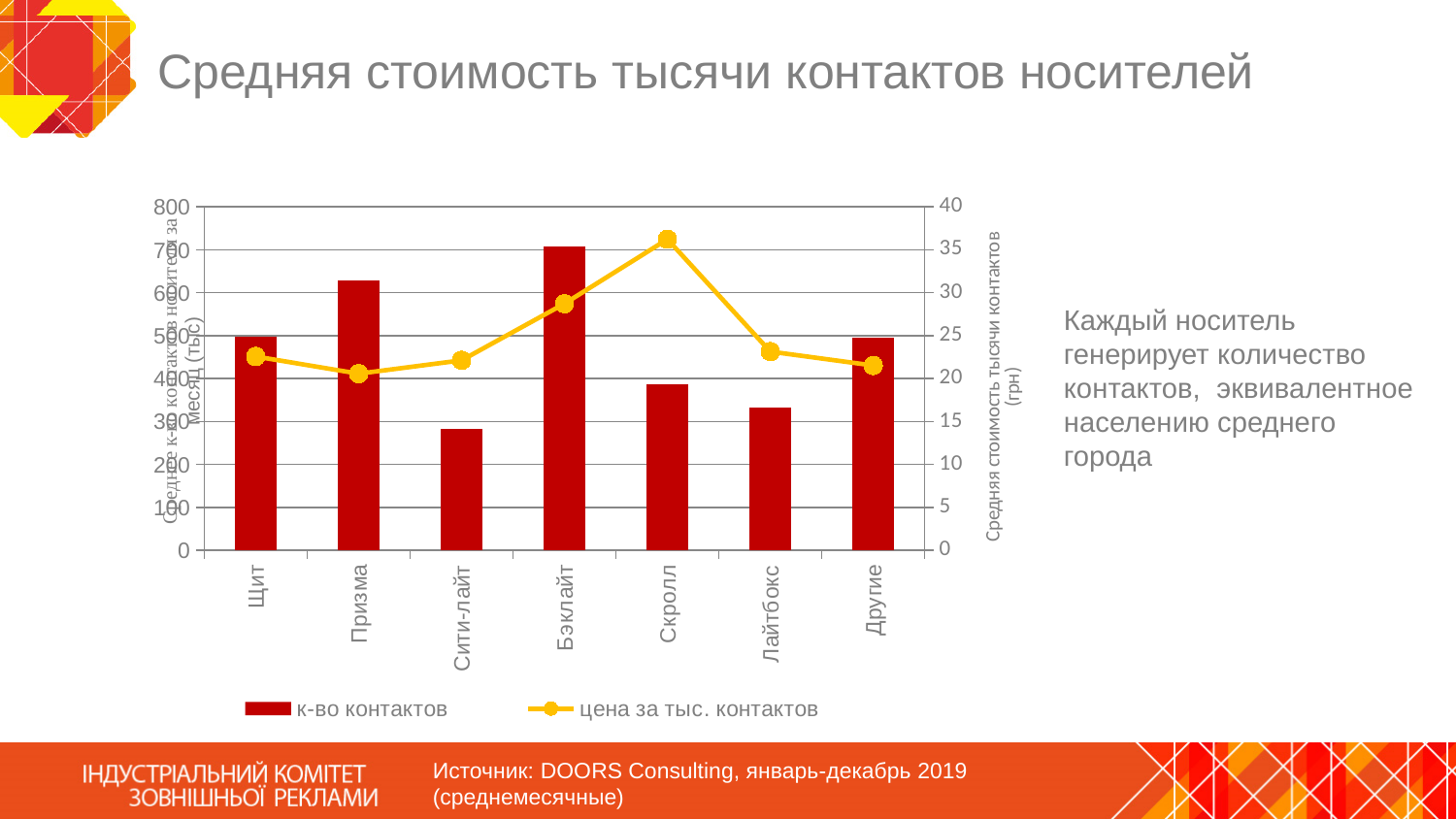
Is the цена за тыс. контактов value for Скролл greater or less than 30? greater What kind of chart is shown on the slide? A combination bar and line chart Is the к-во контактов bar for Бэклайт greater or less than 600? greater Which category has the highest value on the цена за тыс. контактов line? Скролл Which has a higher цена за тыс. контактов value, Бэклайт or Лайтбокс? Бэклайт Which category has the highest bar for к-во контактов? Бэклайт What is the title of the slide containing the chart? Средняя стоимость тысячи контактов носителей Is the к-во контактов bar for Сити-лайт greater or less than 400? less Which has a larger к-во контактов bar, Призма or Скролл? Призма Which category has the lowest bar for к-во контактов? Сити-лайт How many series does the chart legend list? 2 How many categories are shown on the x axis of the chart? 7